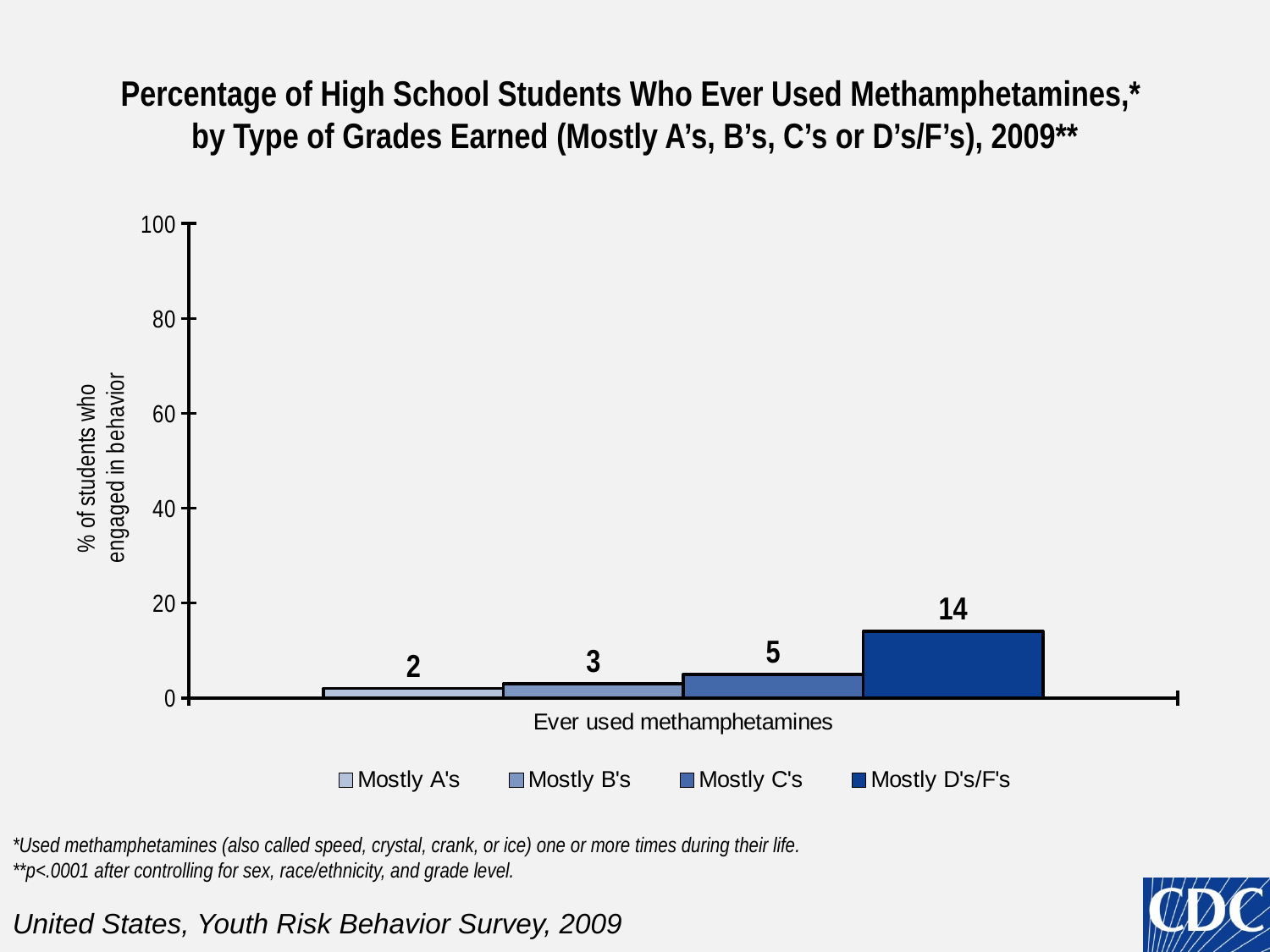
Which grade group has the lowest percentage of students who ever used methamphetamines? Mostly A's What percentage of students with mostly B's ever used methamphetamines? 3 How many series does the legend list? 4 Is the value for mostly D's/F's greater or less than 20? less What kind of chart is shown on the slide? Bar chart What is the label on the y axis of the chart? % of students who engaged in behavior What percentage of students with mostly D's/F's ever used methamphetamines? 14 Which grade group has the highest percentage of students who ever used methamphetamines? Mostly D's/F's What percentage of students with mostly C's ever used methamphetamines? 5 What percentage of students with mostly A's ever used methamphetamines? 2 Which is larger: the value for mostly C's or the value for mostly B's? Mostly C's What is the difference in percentage points between students with mostly D's/F's and students with mostly A's? 12